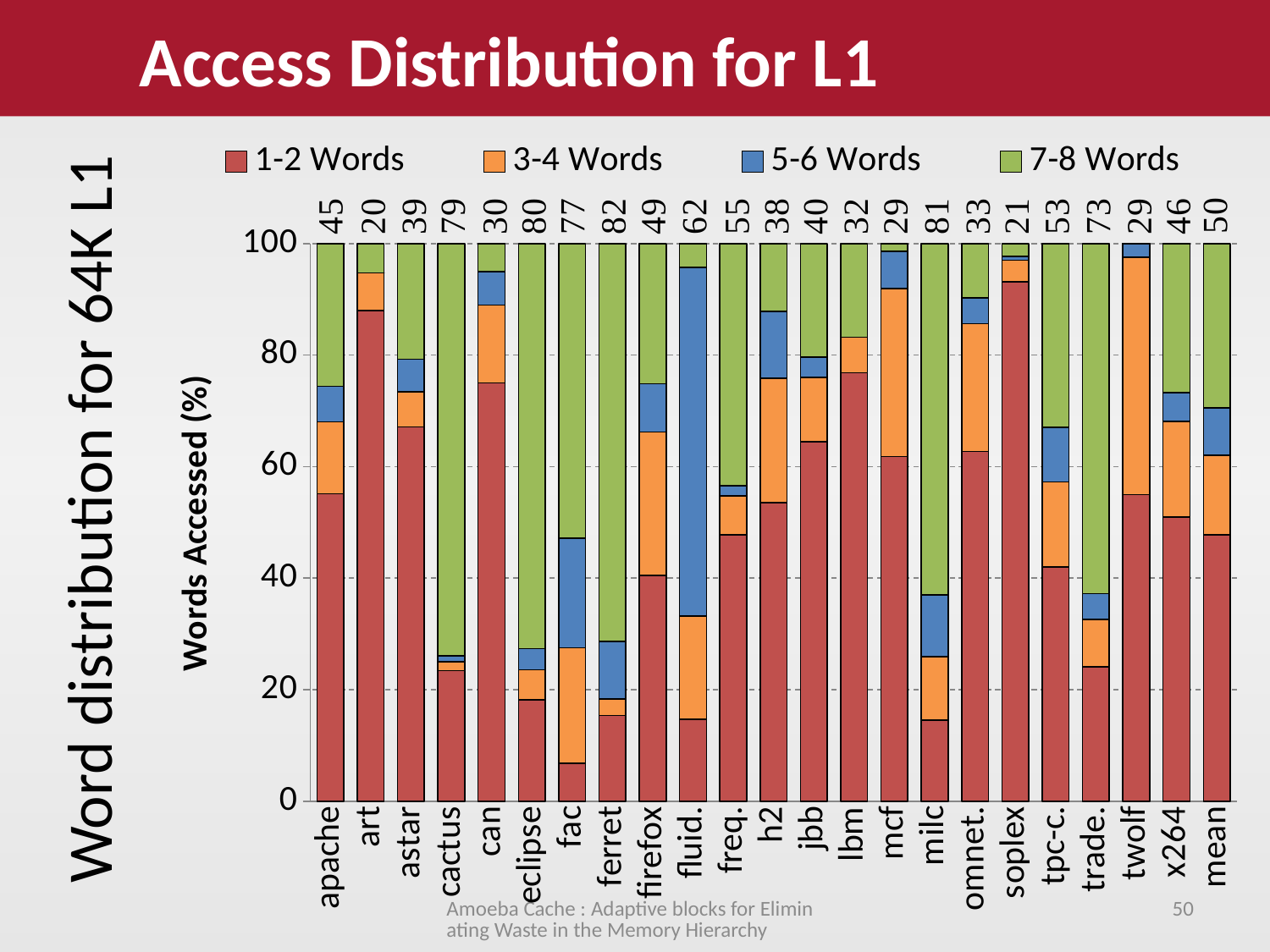
Is the 1-2 Words share for fac greater or less than 20? less Which category has the lowest number printed above its bar? art What kind of chart is shown on the slide? stacked bar chart What number is printed above the bar for ferret? 82 Which category has the highest number printed above its bar? ferret What is the difference between the numbers printed above the bars for ferret and art? 62 How many series does the legend list? 4 What is the label of the y axis? Words Accessed (%) What number is printed above the bar for milc? 81 Is the 1-2 Words share for art greater or less than 80? greater How many benchmark categories are plotted along the x axis (including mean)? 23 What number is printed above the bar for mean? 50